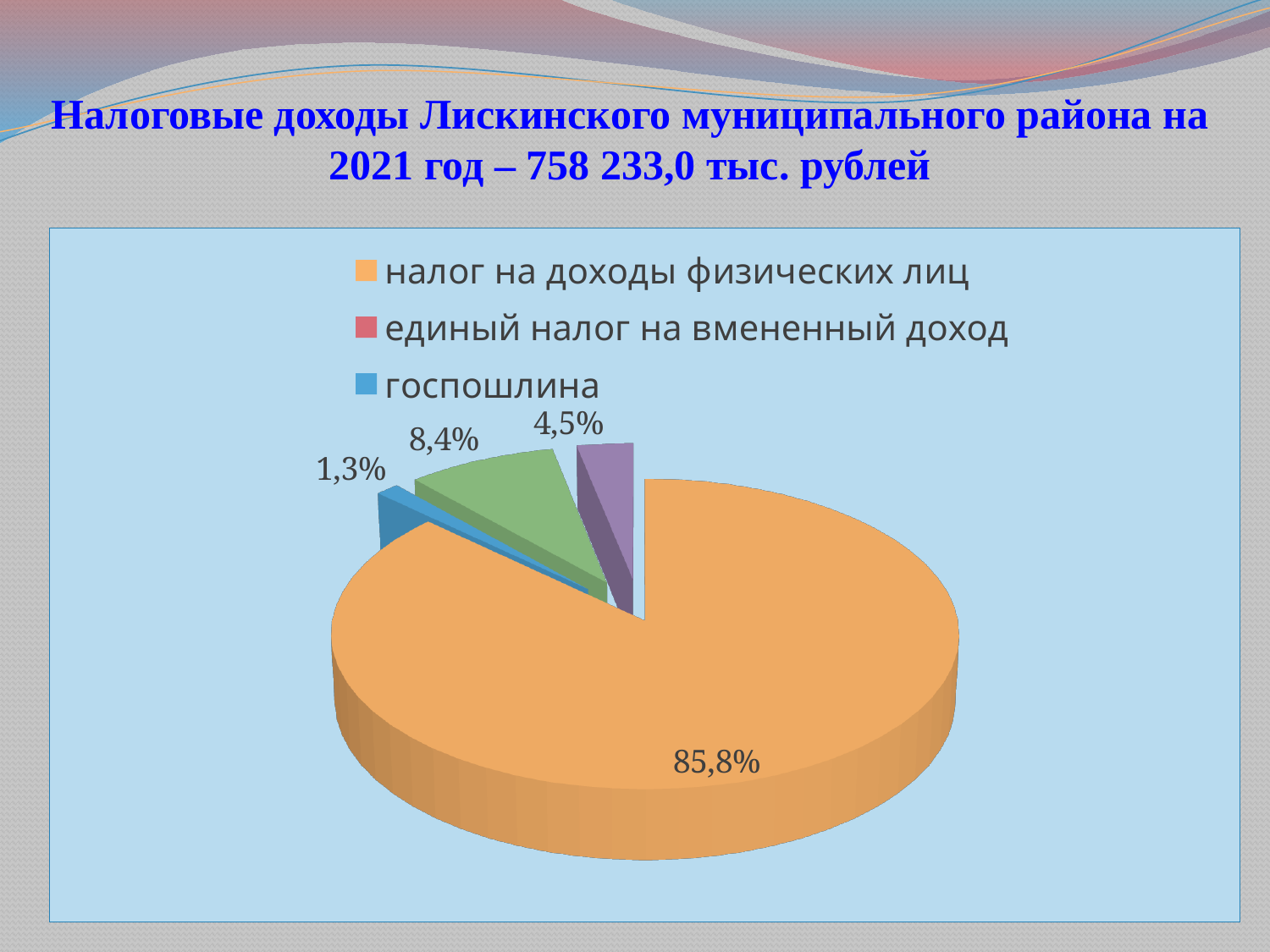
Which category has the largest slice of the pie? налог на доходы физических лиц What kind of chart is shown on the slide? pie chart What share of the pie is labelled for налог на доходы физических лиц? 85,8% What percentage is labelled on the purple slice of the pie? 4,5% What percentage is labelled on the green slice of the pie? 8,4% According to the slide title, what is the total tax revenue of the Лискинский municipal district for 2021? 758 233,0 тыс. рублей Which is larger: the share for налог на доходы физических лиц or the share for госпошлина? налог на доходы физических лиц What share of the pie is labelled for госпошлина? 1,3% What is the smallest percentage labelled on the pie chart? 1,3% How many slices does the pie chart have? 4 What is the difference in percentage points between the share for налог на доходы физических лиц and the share for госпошлина? 84,5 How many entries does the legend list? 3